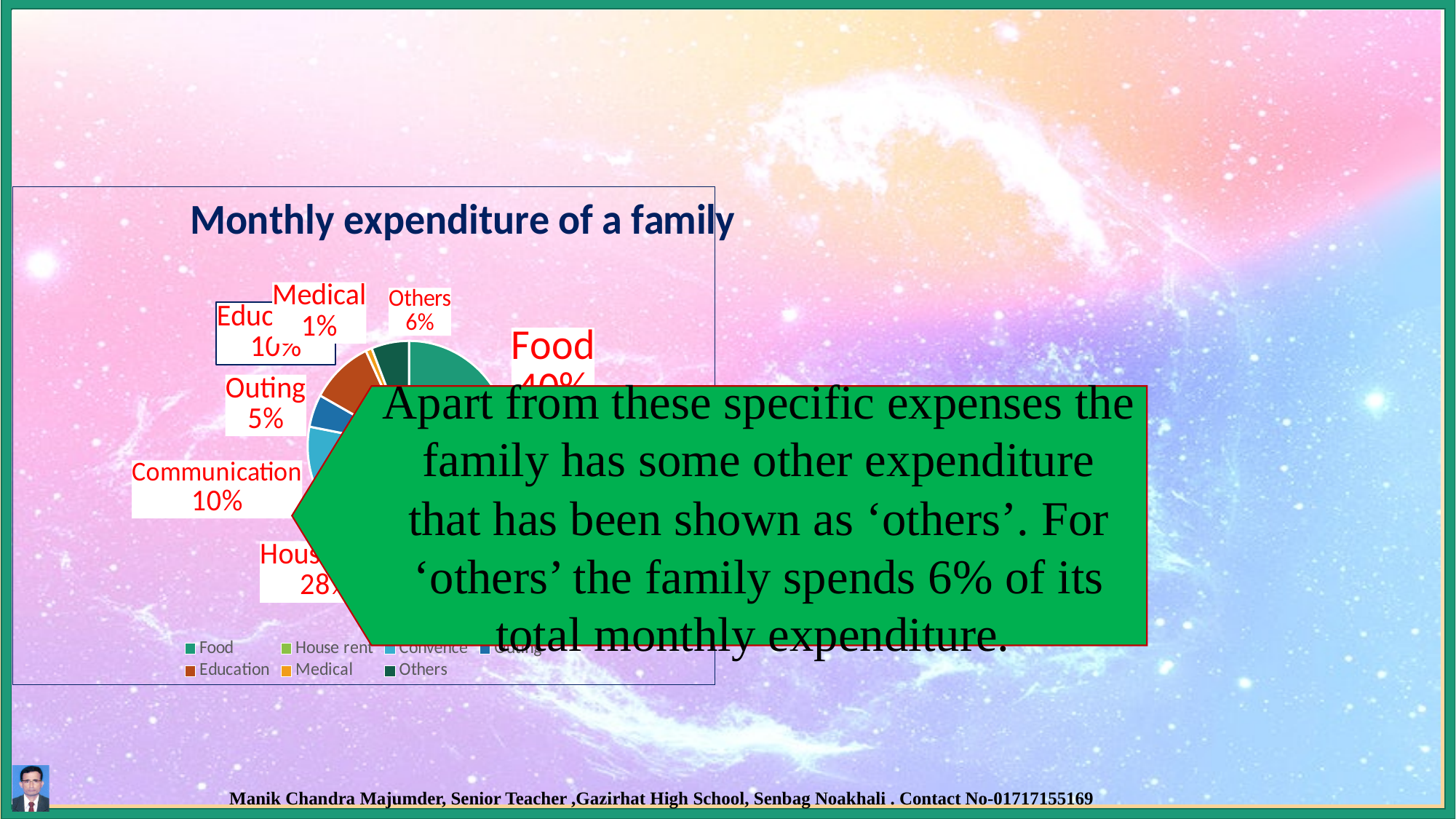
What percentage of the monthly expenditure goes to Others? 6% What percentage of the monthly expenditure goes to Outing? 5% What colour is the Others slice in the legend? dark green Which labelled category has the smallest share of the monthly expenditure? Medical What is the difference between the Communication share and the Medical share? 9% What kind of chart is shown on the slide? pie chart What is the difference between the Others share and the Outing share? 1% What is the title of the chart? Monthly expenditure of a family What percentage of the monthly expenditure goes to Medical? 1% Which is larger, the share for Others or the share for Outing? Others How many entries does the legend list? 7 What percentage of the monthly expenditure goes to Communication? 10%